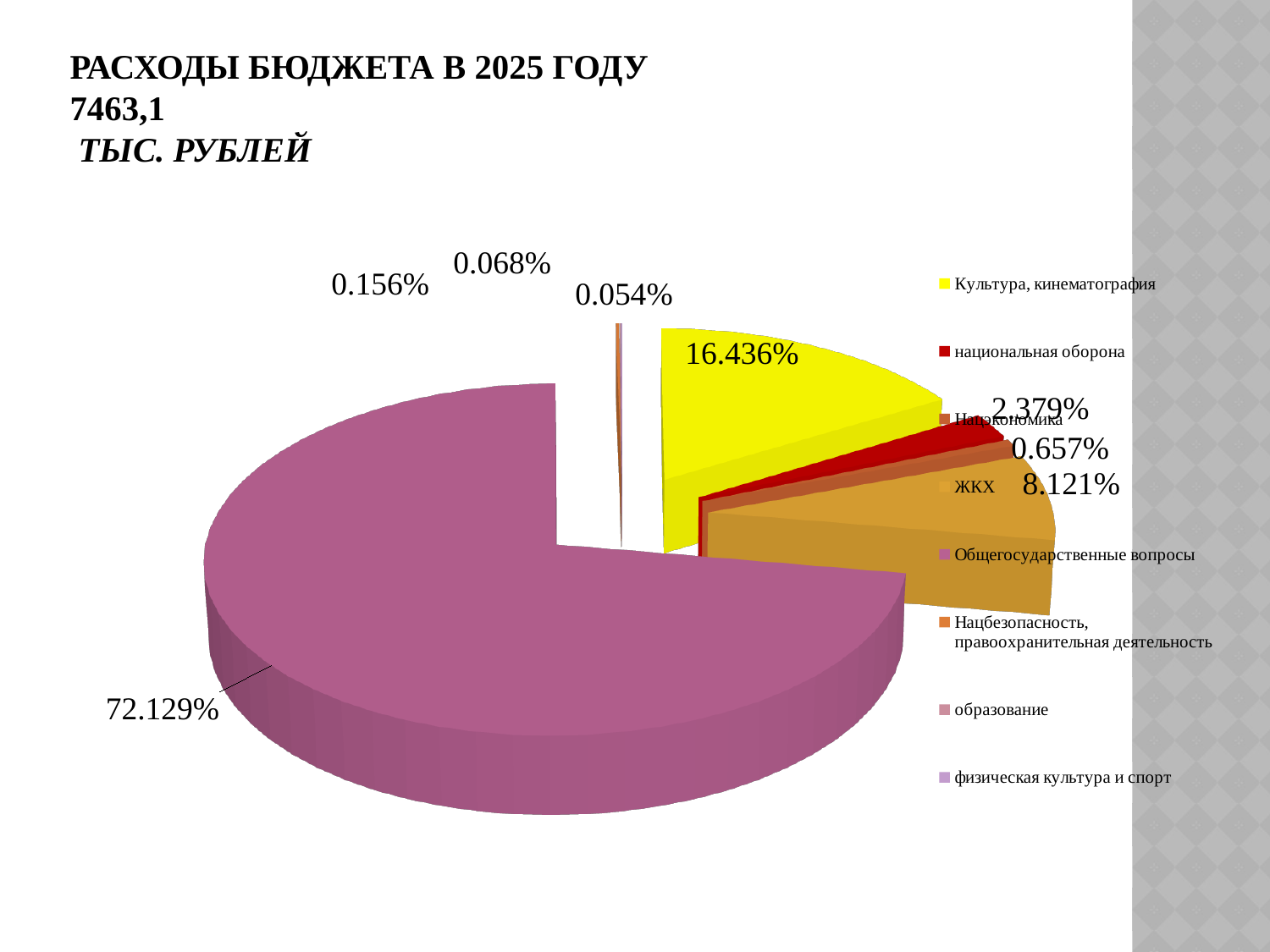
Which is larger: the share for Культура, кинематография or the share for ЖКХ? Культура, кинематография What is the difference between the share for Общегосударственные вопросы and the share for Культура, кинематография? 55.693% What kind of chart is shown on the slide? pie chart What share of the pie does ЖКХ have? 8.121% What share of the pie does Общегосударственные вопросы have? 72.129% What is the title of the slide with the pie chart? РАСХОДЫ БЮДЖЕТА В 2025 ГОДУ Which category has the largest share of the pie chart? Общегосударственные вопросы What total budget expenditure amount is stated on the slide? 7463,1 тыс. рублей What share of the pie does Культура, кинематография have? 16.436% What is the smallest percentage labelled on the pie chart? 0.054% How many categories does the legend of the pie chart list? 8